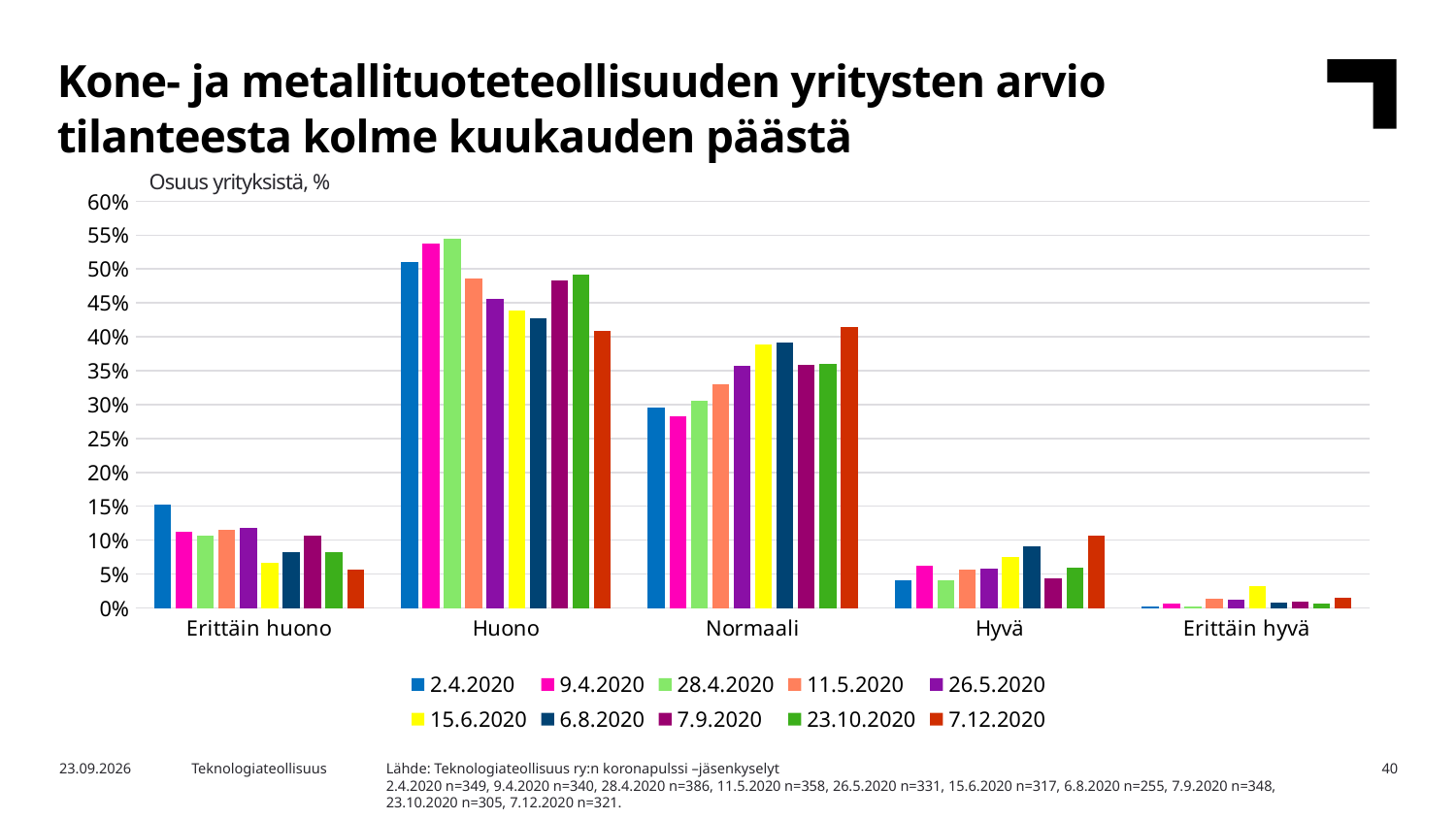
Is the value for Huono on 28.4.2020 greater or less than 50%? greater Which category has the lowest values across all survey dates? Erittäin hyvä Is the value for Erittäin huono on 2.4.2020 greater or less than 10%? greater How many series does the legend list? 10 How many categories are shown on the x axis of the chart? 5 Is the value for Hyvä on 7.12.2020 greater or less than 5%? greater What is the label shown above the y axis of the chart? Osuus yrityksistä, % What kind of chart is shown on the slide? bar chart Within the Normaali category, which survey date has the highest value? 7.12.2020 For the 2.4.2020 series, which is larger: the value for Huono or the value for Normaali? Huono Which category has the highest value for the 2.4.2020 series? Huono